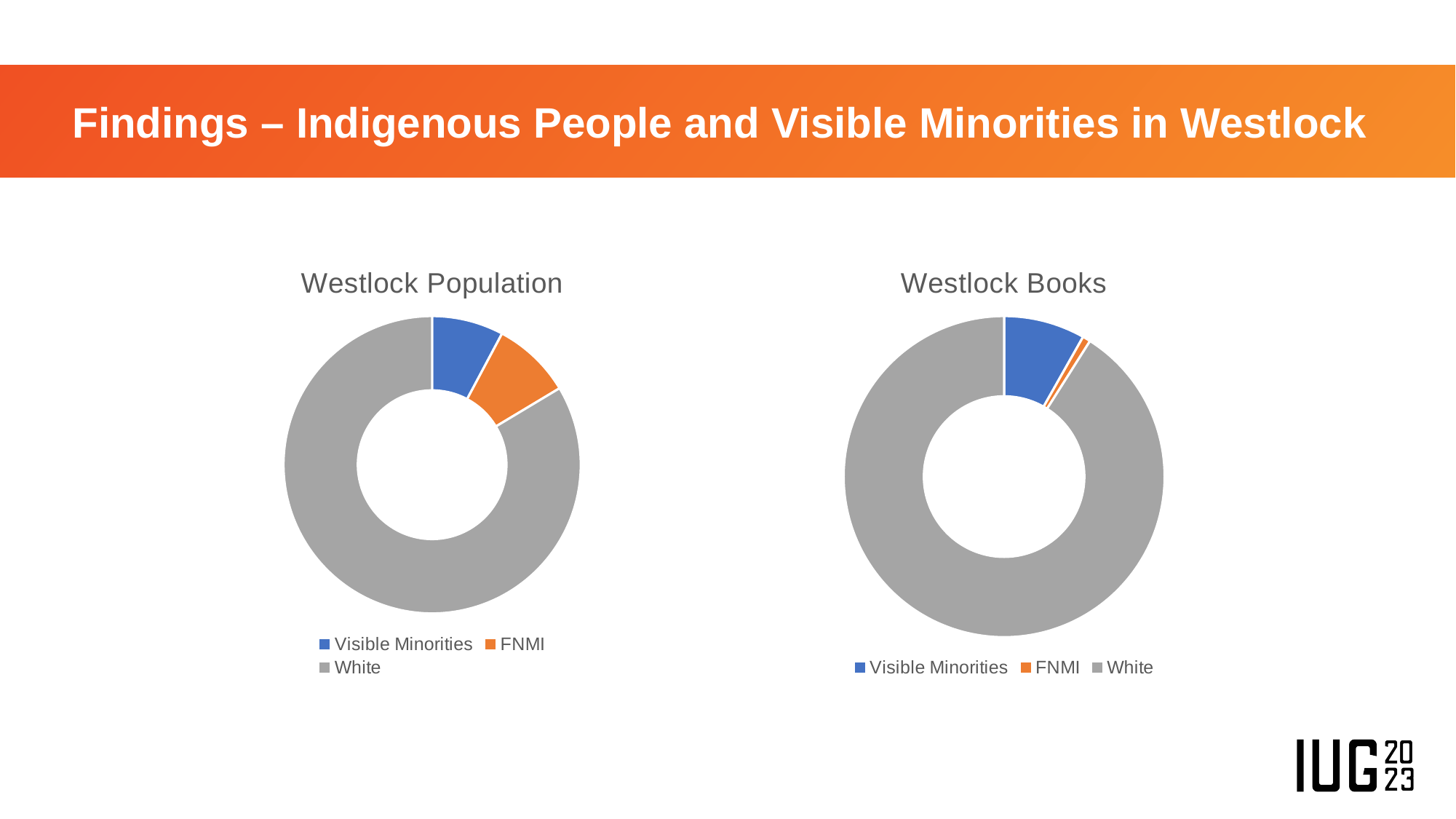
In the Westlock Population chart, which category has the largest share? White In the Westlock Population chart, which is larger: White or FNMI? White How many entries does the legend of the Westlock Books chart list? 3 What is the title of the chart on the left side of the slide? Westlock Population In the Westlock Books chart, which colour represents FNMI? orange How many categories does the Westlock Population chart show? 3 In the Westlock Books chart, which is larger: Visible Minorities or FNMI? Visible Minorities What kind of chart is the Westlock Books chart? doughnut chart What kind of chart is the Westlock Population chart? doughnut chart In the Westlock Books chart, which category has the largest share? White In the Westlock Books chart, which category has the smallest share? FNMI